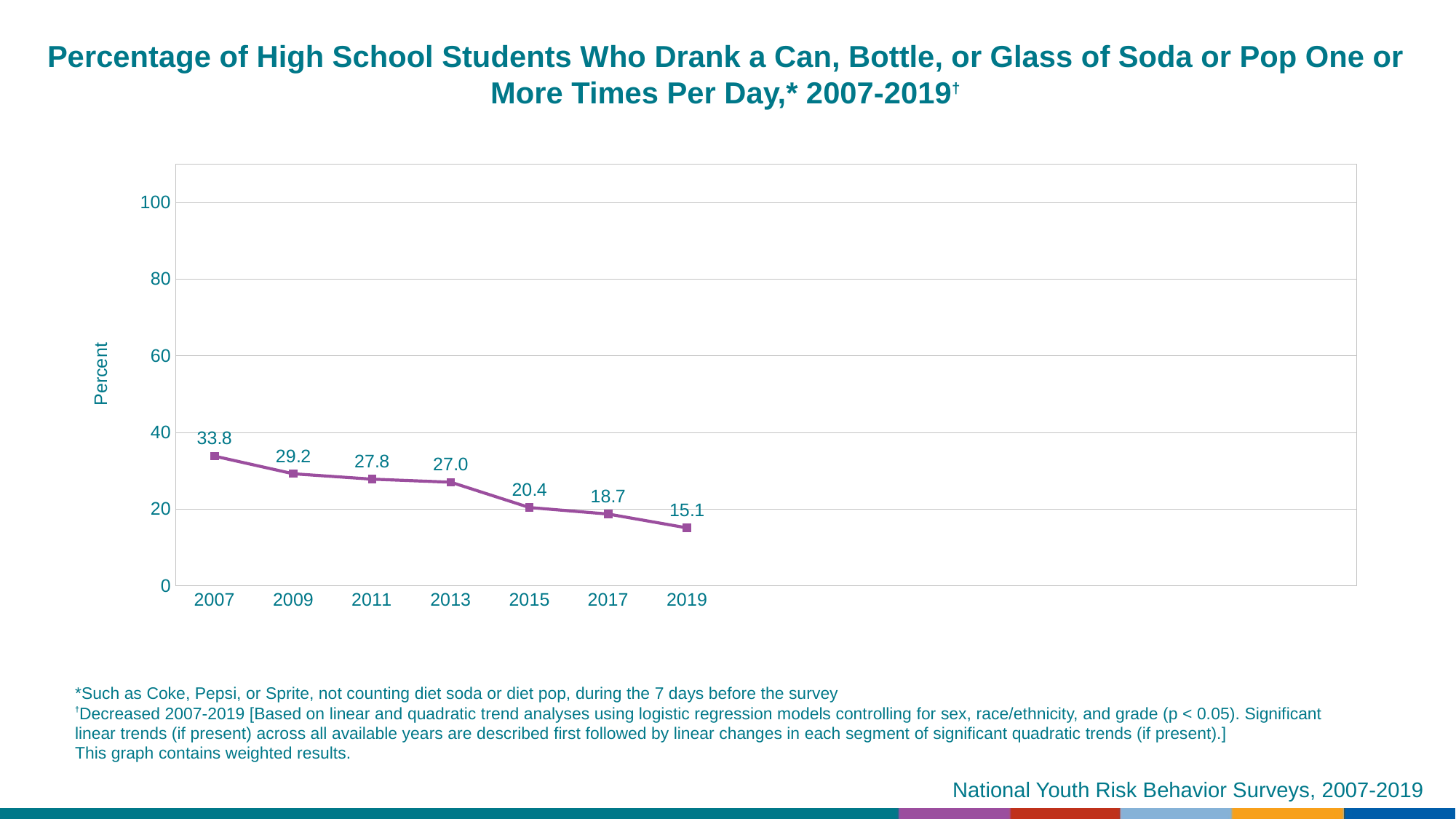
What is the value plotted for 2019? 15.1 Is the value for 2015 greater or less than 40? less How many years are plotted on the chart? 7 Which year has the highest percentage? 2007 What kind of chart is shown on the slide? line chart What is the value plotted for 2013? 27.0 What is the difference between the 2013 and 2015 values? 6.6 Which year has the lowest percentage? 2019 Which year has a larger value, 2009 or 2017? 2009 By how many percentage points did the value fall from 2007 to 2019? 18.7 Do the values rise or fall from 2007 to 2019? fall What percentage of high school students drank soda or pop one or more times per day in 2007? 33.8